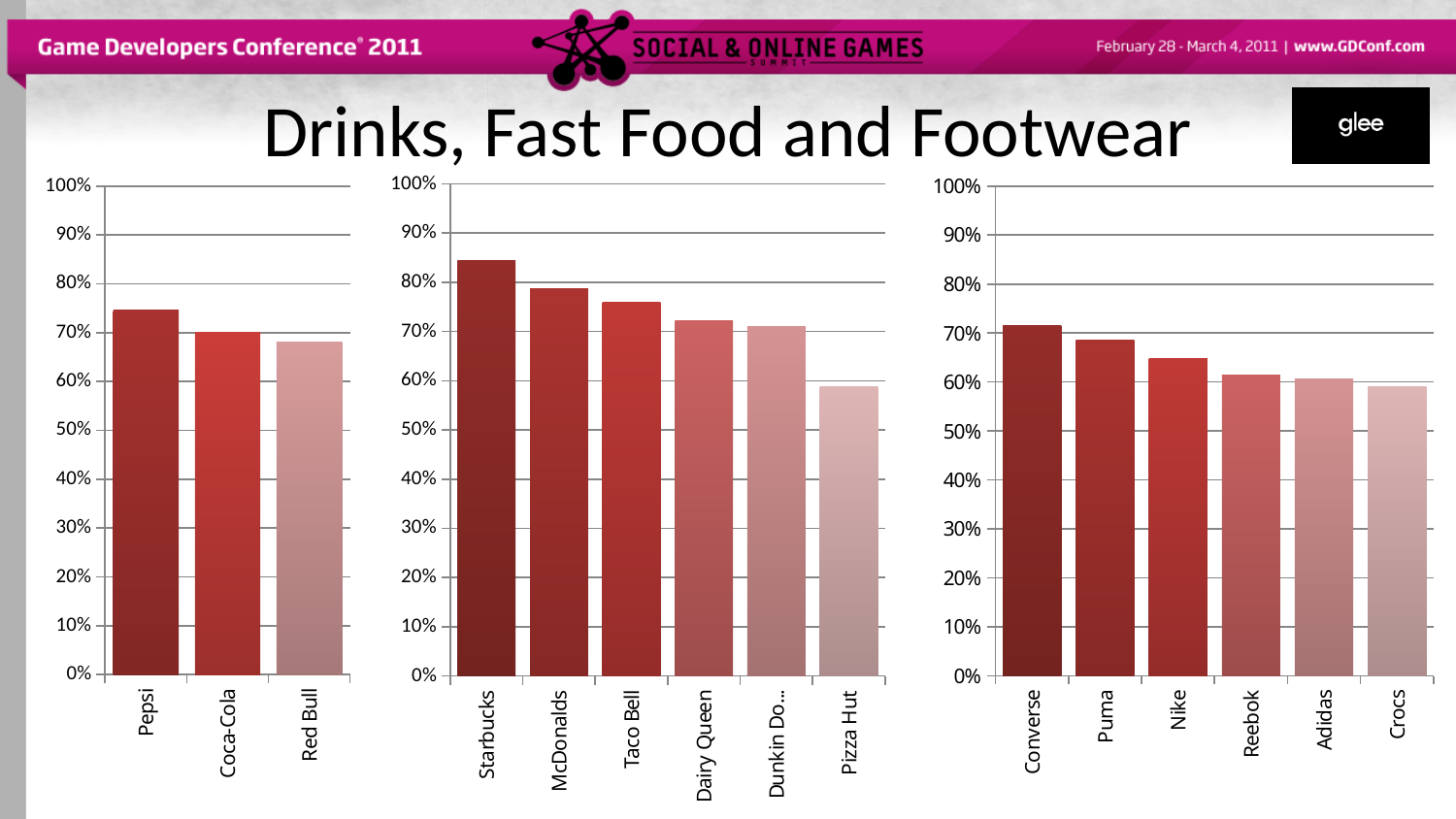
In the right chart, is the value for Nike greater or less than 70%? less In the right chart, which category has the lowest value? Crocs How many categories are shown in the right chart (Converse to Crocs)? 6 What kind of chart is the left chart (Pepsi, Coca-Cola, Red Bull)? Bar chart In the middle chart, which category has the highest value? Starbucks In the left chart, which category has the highest value? Pepsi How many categories are shown in the middle chart (Starbucks to Pizza Hut)? 6 In the middle chart, is the value for Starbucks greater or less than 80%? greater In the middle chart, do the values rise or fall from left to right along the x axis? Fall In the right chart, which category has the highest value? Converse In the left chart, is the value for Pepsi greater or less than 70%? greater In the middle chart, which category has the lowest value? Pizza Hut